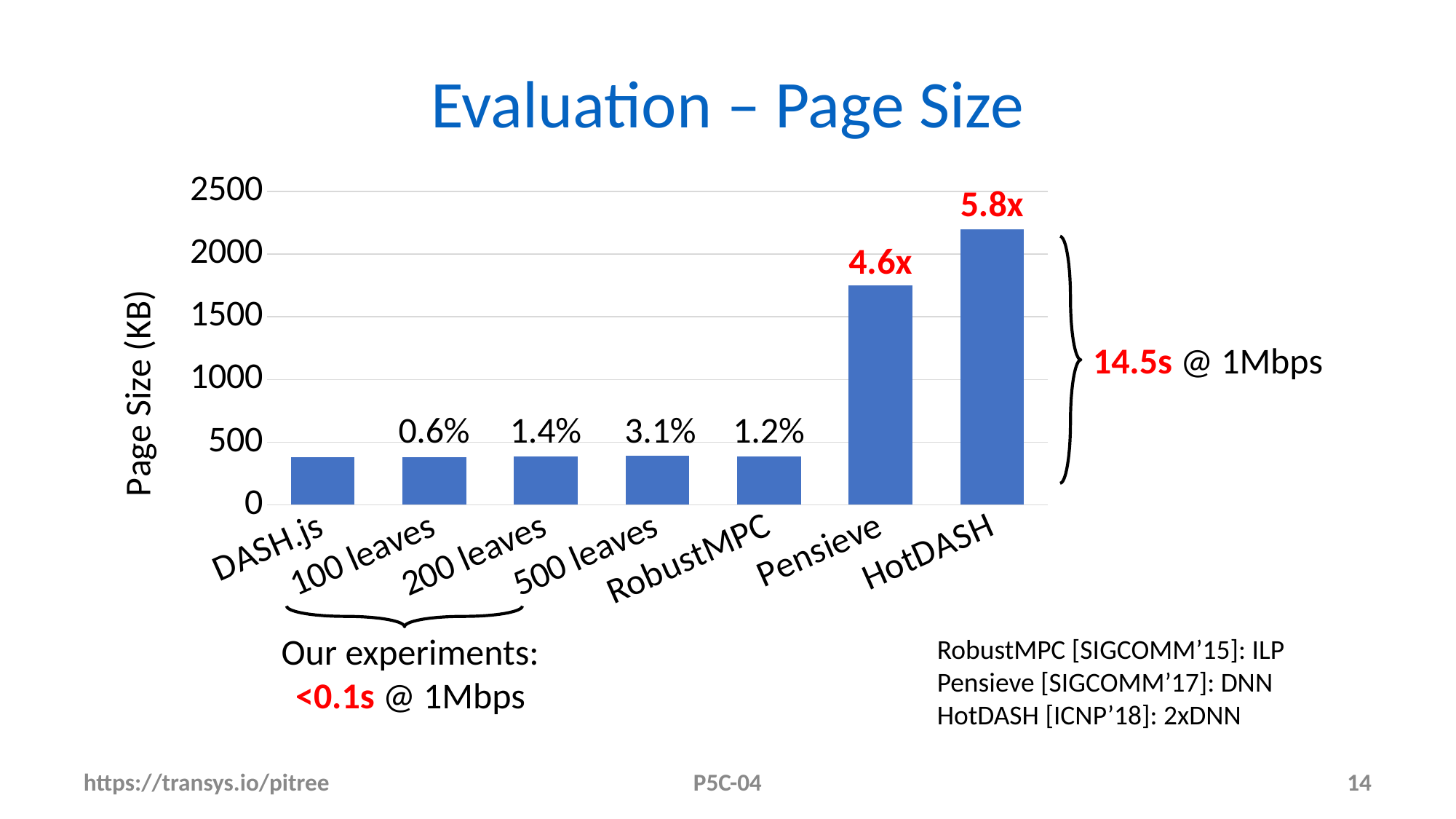
Is the page size for DASH.js greater or less than 500? less What label is printed above the 100 leaves bar? 0.6% Is the page size for HotDASH greater or less than 2000? greater Is the page size for Pensieve greater or less than 2000? less Which category has the highest page size? HotDASH What kind of chart is shown on the slide? bar chart What label is printed above the Pensieve bar? 4.6x Which has the larger page size, Pensieve or RobustMPC? Pensieve What is the label of the y axis? Page Size (KB) What label is printed above the HotDASH bar? 5.8x How many categories are shown on the x axis of the chart? 7 What label is printed above the 500 leaves bar? 3.1%